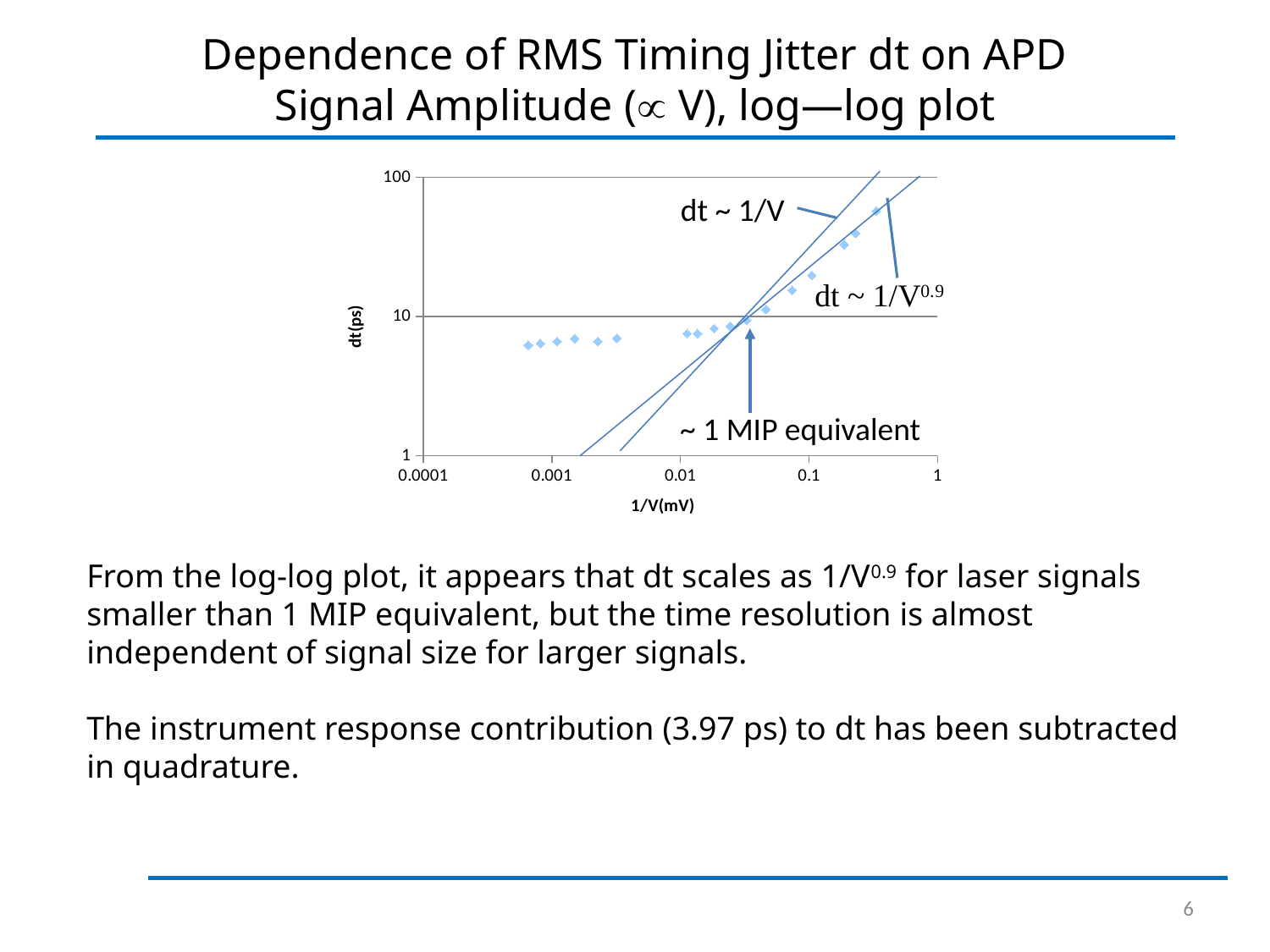
Is the dt value for the rightmost data point (near 1/V = 0.3 mV) greater or less than 10 ps? greater Which has the larger dt value: the data point near 1/V = 0.2 mV or the data point near 1/V = 0.001 mV? the point near 1/V = 0.2 mV What is the label on the y axis of the chart? dt(ps) Is the dt value for the data points near 1/V = 0.001 mV greater or less than 1 ps? greater Is the dt value for the rightmost data point (near 1/V = 0.3 mV) greater or less than 100 ps? less What kind of chart is shown on the slide? scatter chart Do the plotted dt values rise or fall as 1/V increases along the x axis? rise What is the label on the x axis of the chart? 1/V(mV)